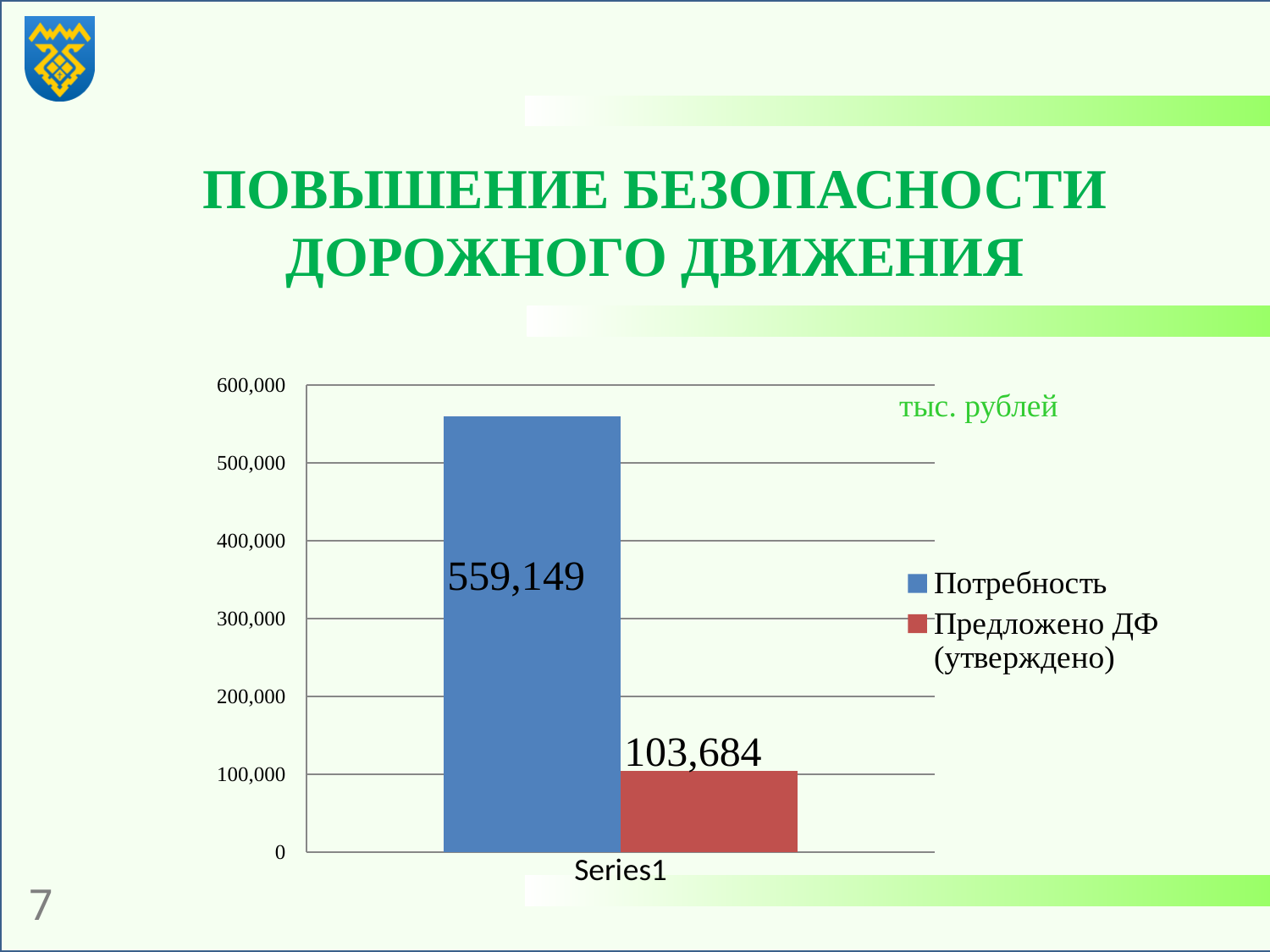
What is the category label shown on the x axis? Series1 How many series does the legend list? 2 What is the difference between the Потребность value and the Предложено ДФ (утверждено) value? 455,465 What unit is indicated for the values on the chart? тыс. рублей What kind of chart is shown on the slide? Bar chart Which series has the higher value, Потребность or Предложено ДФ (утверждено)? Потребность What is the value of the Потребность bar? 559,149 Is the value for Предложено ДФ (утверждено) greater or less than 200,000? less Is the value for Потребность greater or less than 500,000? greater Which series has the lowest value on the chart? Предложено ДФ (утверждено) What is the maximum value shown on the vertical axis? 600,000 What is the value of the Предложено ДФ (утверждено) bar? 103,684